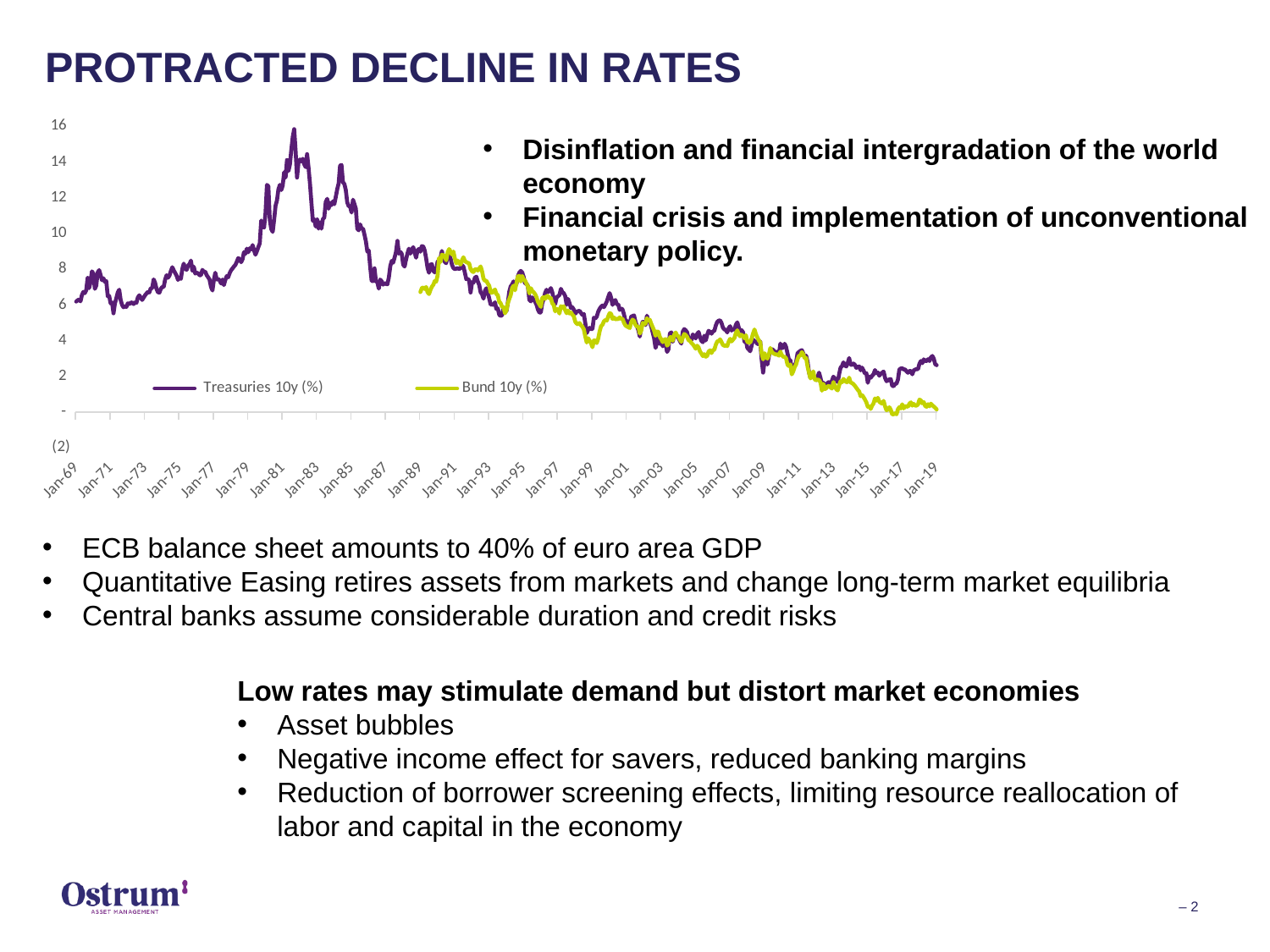
Is the highest value of the Treasuries 10y (%) line greater or less than 14? greater How many series does the chart's legend list? 2 Is the value of Bund 10y (%) at Jan-19 greater or less than 2? less Is the value of Treasuries 10y (%) at Jan-09 greater or less than 6? less What are the two series named in the chart's legend? Treasuries 10y (%) and Bund 10y (%) Between which two x-axis labels does the Treasuries 10y (%) line reach its peak? Jan-81 and Jan-83 Does the Treasuries 10y (%) line generally rise or fall from Jan-83 to Jan-19? fall What colour is the Treasuries 10y (%) line in the chart? purple At Jan-19, which series is higher, Treasuries 10y (%) or Bund 10y (%)? Treasuries 10y (%) Does the Bund 10y (%) line generally rise or fall from Jan-91 to Jan-19? fall What kind of chart is shown on the slide? line chart